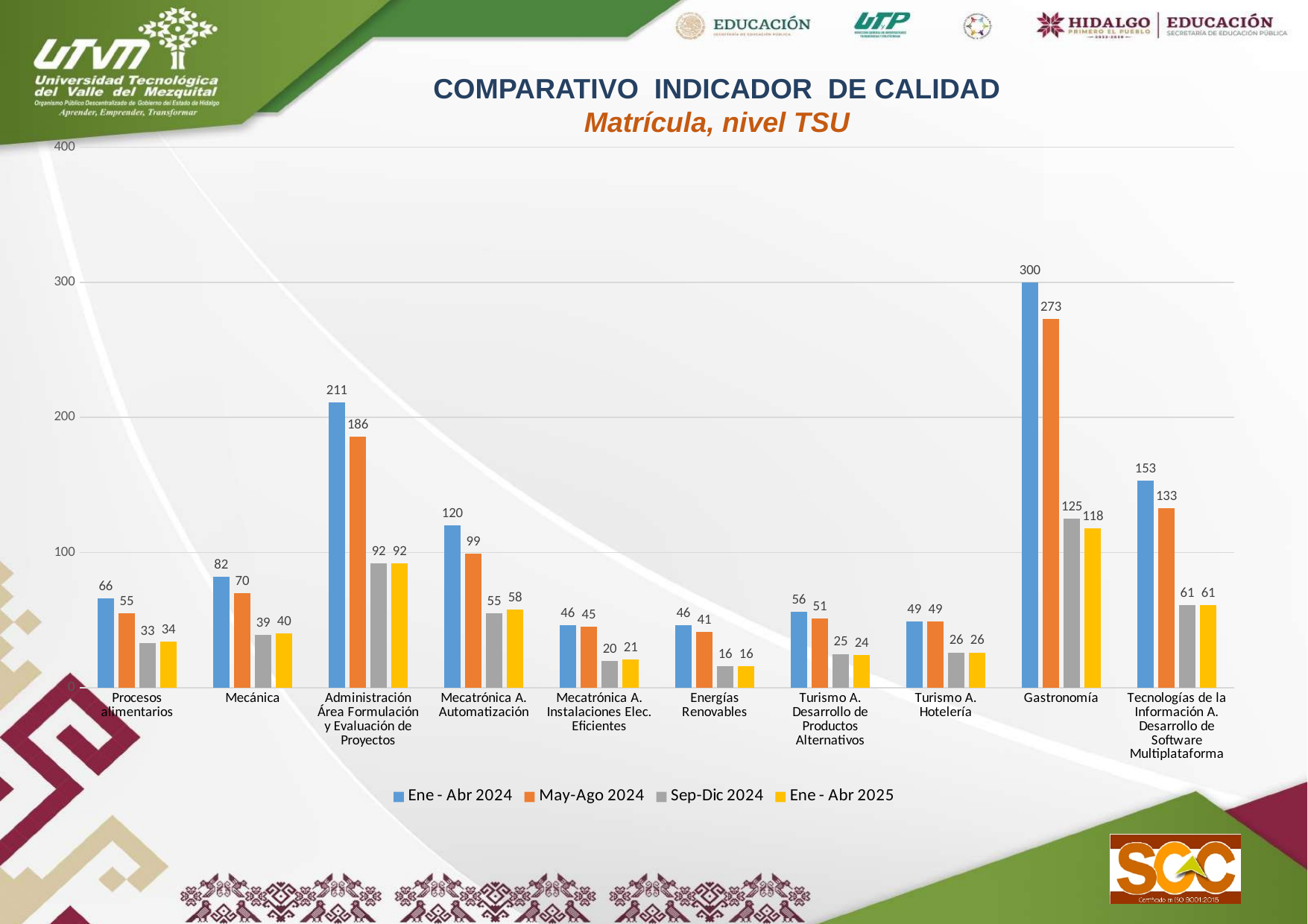
What is the Sep-Dic 2024 value for Mecatrónica A. Automatización? 55 What is the subtitle of the chart? Matrícula, nivel TSU What is the Ene - Abr 2024 value for Gastronomía? 300 What is the Ene - Abr 2025 value for Tecnologías de la Información A. Desarrollo de Software Multiplataforma? 61 What is the difference between the Ene - Abr 2024 and Ene - Abr 2025 values for Administración Área Formulación y Evaluación de Proyectos? 119 Which is larger for Mecánica: the Ene - Abr 2024 value or the May-Ago 2024 value? Ene - Abr 2024 How many categories are shown on the x axis? 10 What kind of chart is shown on the slide? Bar chart Is the May-Ago 2024 value for Gastronomía greater or less than 200? greater Which category has the highest May-Ago 2024 value? Gastronomía How many series does the legend list? 4 Which category has the lowest Sep-Dic 2024 value? Energías Renovables